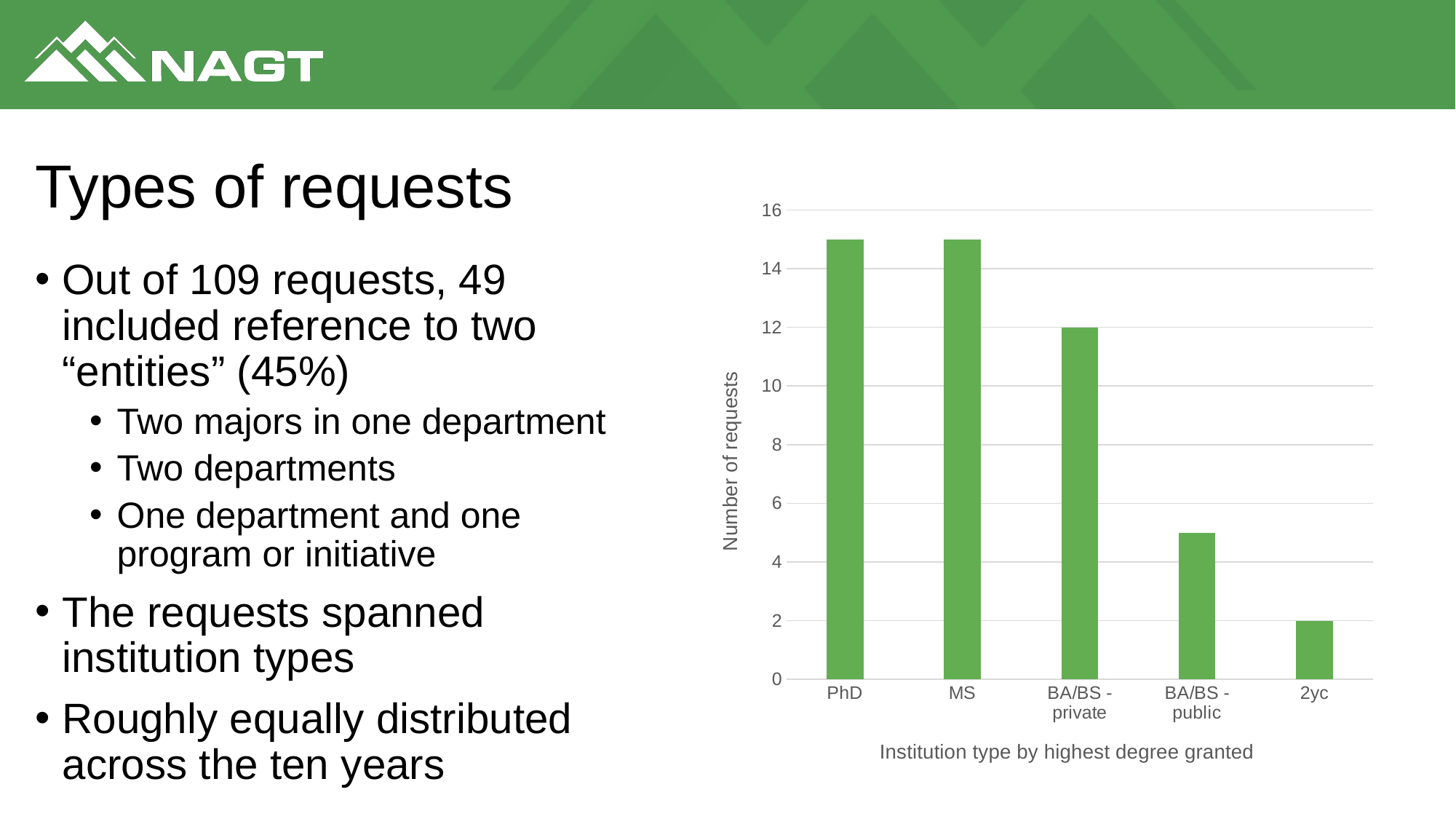
What is the title of the x axis of the chart? Institution type by highest degree granted Which has more requests, PhD or BA/BS - private? PhD What is the number of requests for 2yc? 2 How many institution types are shown on the x axis of the chart? 5 What is the difference in number of requests between BA/BS - private and 2yc? 10 Is the number of requests for MS greater or less than 14? greater Is the number of requests for PhD greater or less than 14? greater Which institution type has the lowest number of requests? 2yc What kind of chart is shown on the slide? bar chart Is the number of requests for BA/BS - public greater or less than 6? less What is the number of requests for BA/BS - private? 12 Do the number of requests generally rise or fall moving from PhD to 2yc along the x axis? fall